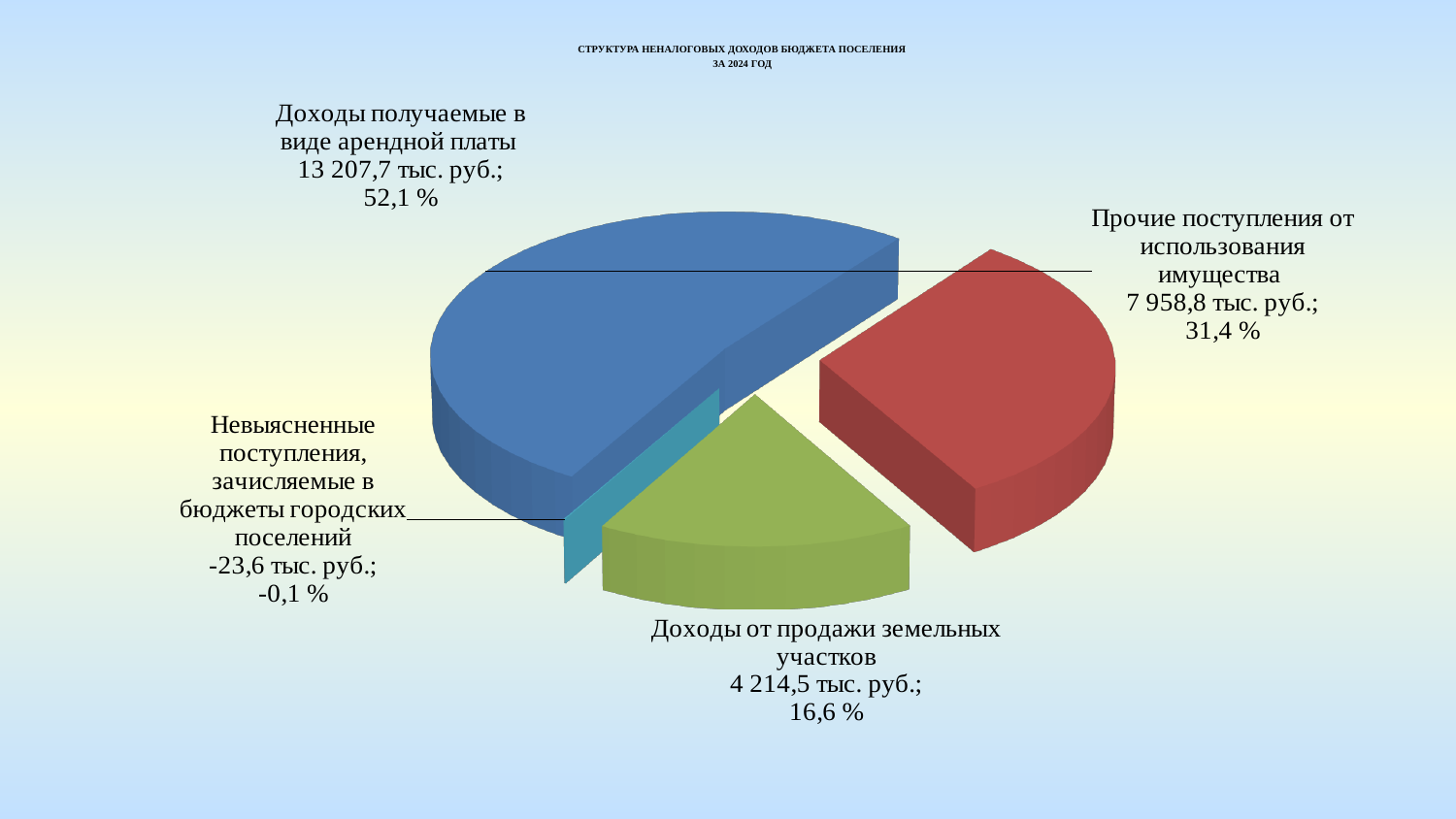
Which category has the smallest value? Невыясненные поступления, зачисляемые в бюджеты городских поселений Which category has the largest share of the pie? Доходы получаемые в виде арендной платы What share of the pie does 'Доходы от продажи земельных участков' represent? 16,6 % What type of chart is shown on the slide? Pie chart How many slices does the pie chart have? 4 What is the value for 'Доходы получаемые в виде арендной платы'? 13 207,7 тыс. руб. What share of the pie does 'Прочие поступления от использования имущества' represent? 31,4 % What is the value for 'Прочие поступления от использования имущества'? 7 958,8 тыс. руб. What is the value for 'Доходы от продажи земельных участков'? 4 214,5 тыс. руб. What is the difference in value between 'Доходы получаемые в виде арендной платы' and 'Прочие поступления от использования имущества'? 5 248,9 тыс. руб. What is the value for 'Невыясненные поступления, зачисляемые в бюджеты городских поселений'? -23,6 тыс. руб. What is the title of the chart? СТРУКТУРА НЕНАЛОГОВЫХ ДОХОДОВ БЮДЖЕТА ПОСЕЛЕНИЯ ЗА 2024 ГОД